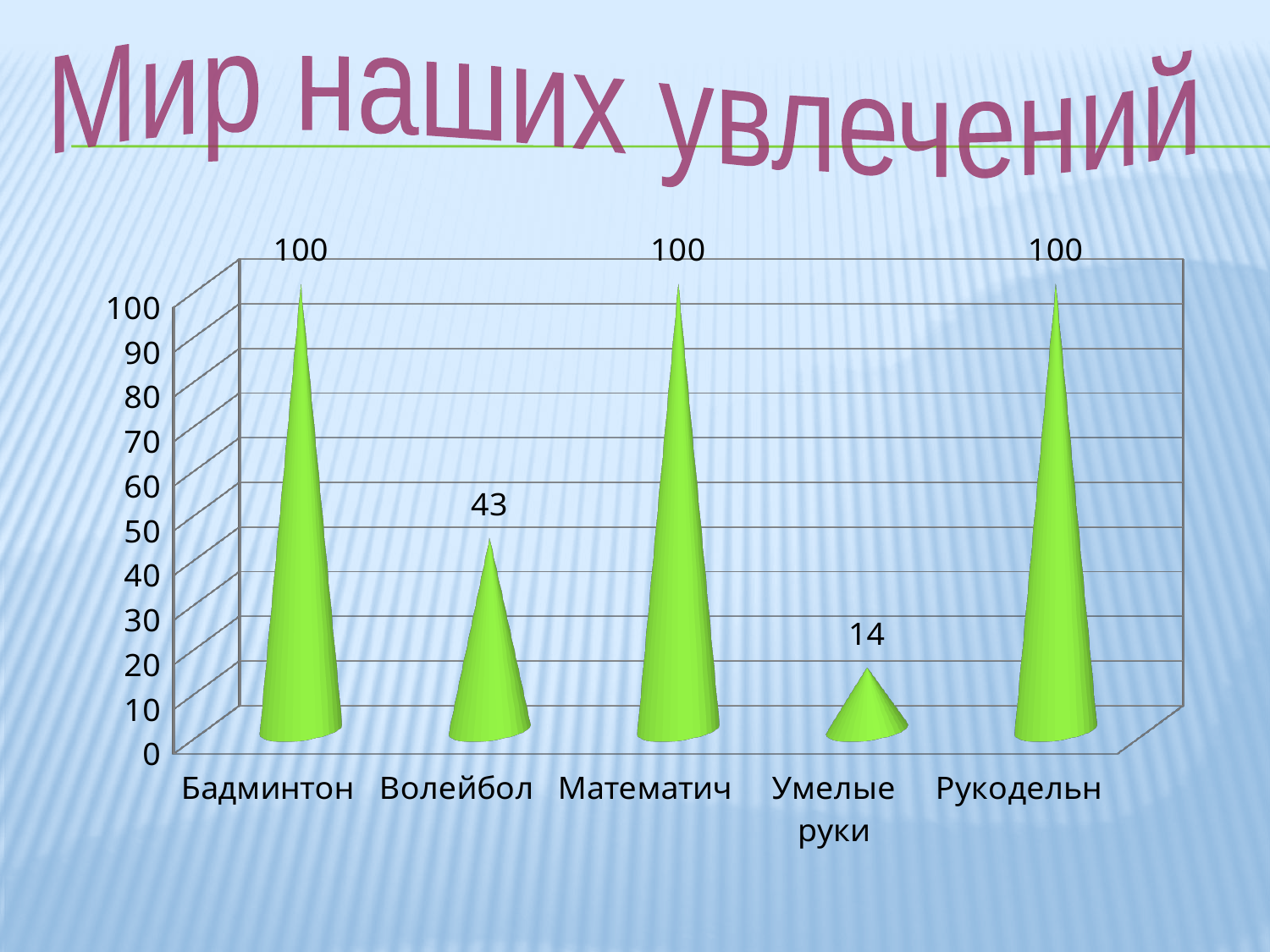
How many categories are shown on the x axis? 5 Is the value for Волейбол greater or less than 50? less What is the value for Волейбол? 43 What kind of chart is shown on the slide? bar chart What is the difference between the values for Волейбол and Умелые руки? 29 What is the value for Рукодельн? 100 Which category has the lowest value? Умелые руки What is the difference between the values for Бадминтон and Волейбол? 57 What is the value for Умелые руки? 14 What is the value for Бадминтон? 100 Which is larger, the value for Волейбол or the value for Умелые руки? Волейбол What is the title of the slide? Мир наших увлечений